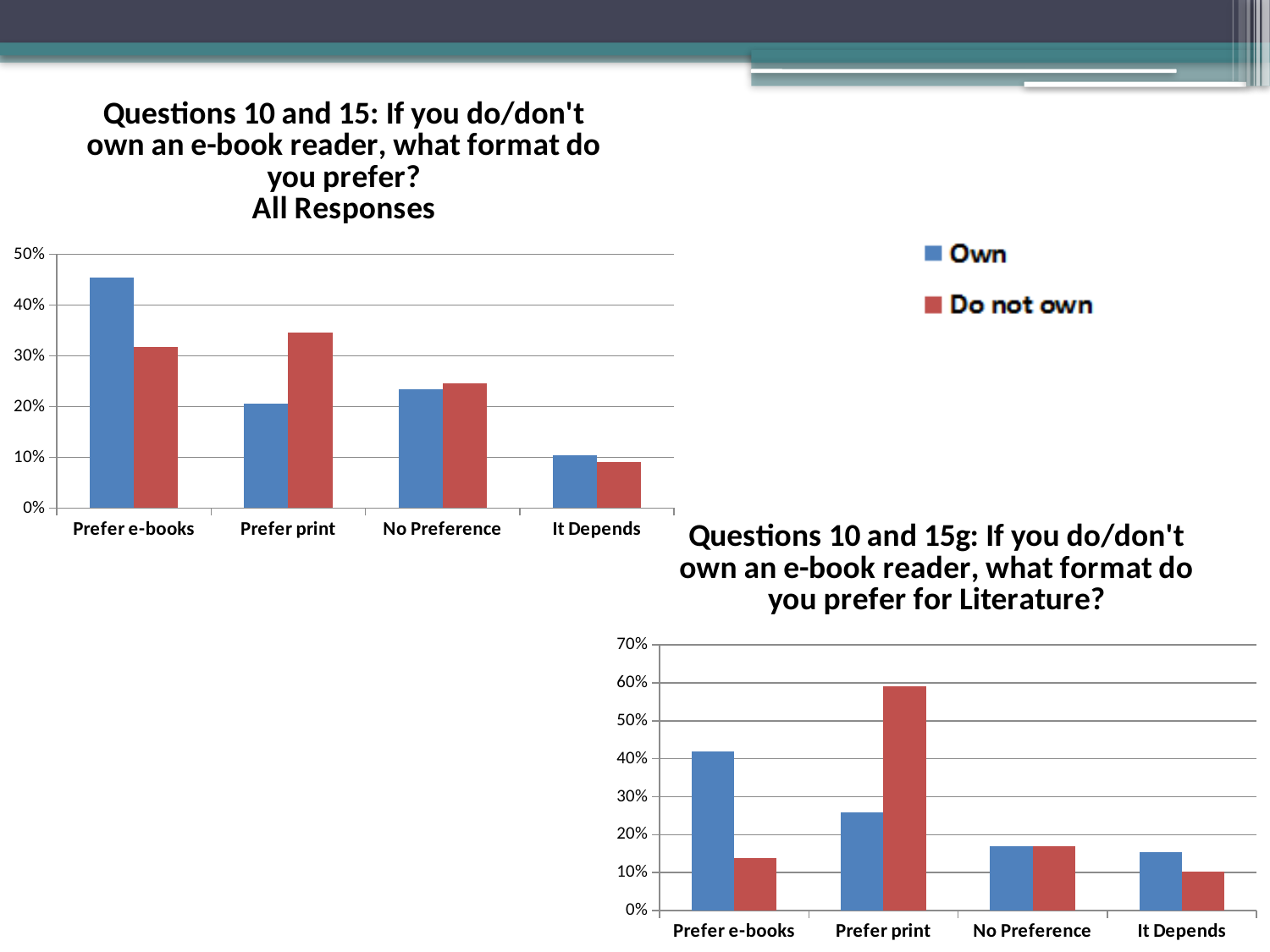
What kind of chart is the 'All Responses' chart on the left? bar chart Which colour represents the Do not own series in the legend? red In the Literature chart on the right, which category has the highest value for the Do not own series? Prefer print In the 'All Responses' chart, which is larger for Prefer print: Own or Do not own? Do not own In the 'All Responses' chart, is the Own value for Prefer e-books greater or less than 40%? greater In the Literature chart on the right, which is larger for Prefer e-books: Own or Do not own? Own In the 'All Responses' chart, which category has the highest value for the Own series? Prefer e-books How many series does the legend list for the charts? 2 In the Literature chart on the right, is the Do not own value for It Depends greater or less than 20%? less How many categories are shown on the x axis of the 'All Responses' chart? 4 In the Literature chart on the right, is the Do not own value for Prefer print greater or less than 50%? greater In the 'All Responses' chart, which category has the lowest value for the Do not own series? It Depends